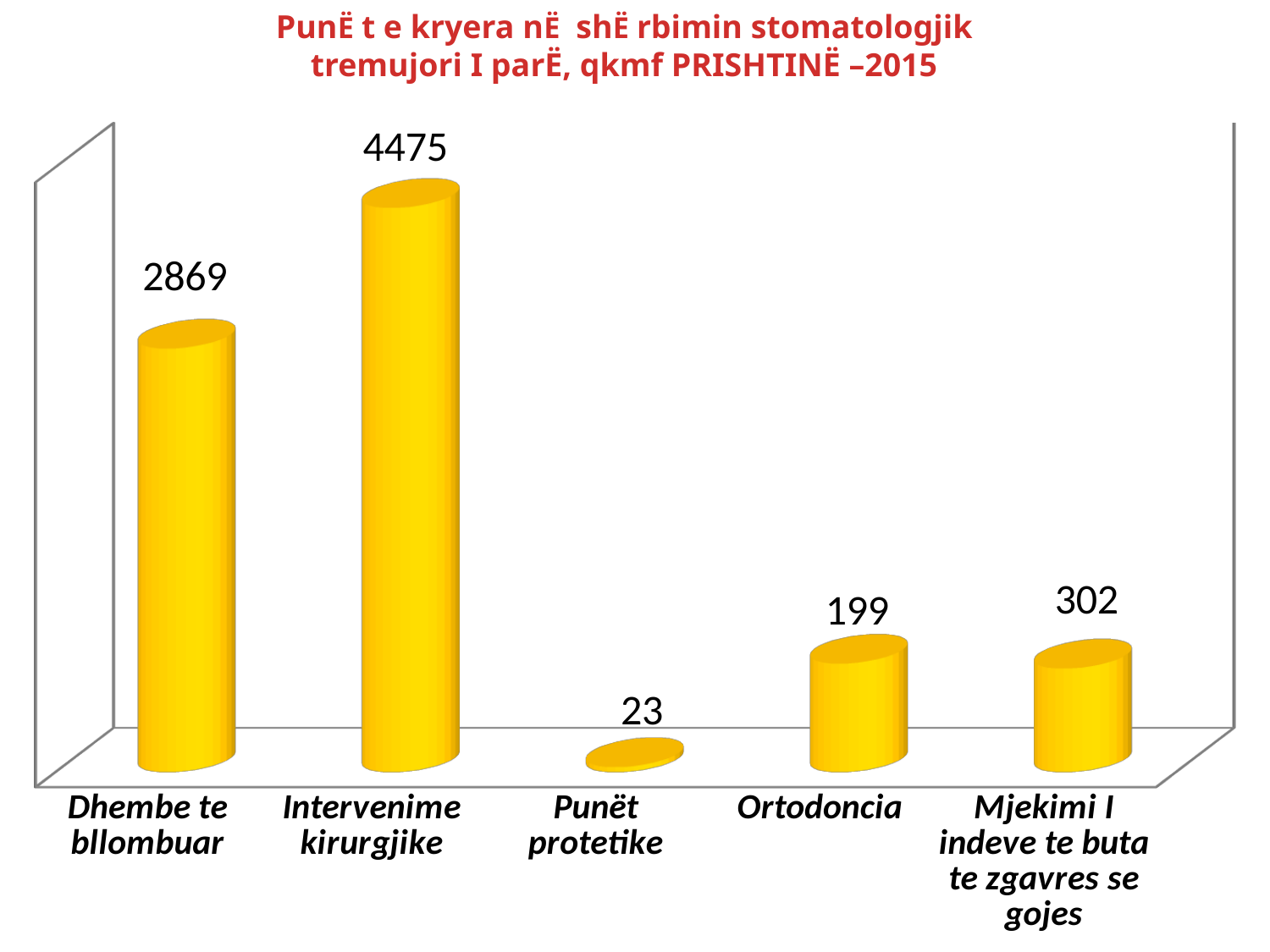
Which category has the highest value? Intervenime kirurgjike What is the difference between the values for Intervenime kirurgjike and Dhembe te bllombuar? 1606 What is the value for Ortodoncia? 199 What is the value for Intervenime kirurgjike? 4475 Which category has the lowest value? Punët protetike What is the value for Dhembe te bllombuar? 2869 What is the difference between the values for Mjekimi I indeve te buta te zgavres se gojes and Ortodoncia? 103 What kind of chart is shown on the slide? Bar chart What is the value for Punët protetike? 23 Which is larger, the value for Ortodoncia or the value for Mjekimi I indeve te buta te zgavres se gojes? Mjekimi I indeve te buta te zgavres se gojes How many categories are shown in the chart? 5 What is the value for Mjekimi I indeve te buta te zgavres se gojes? 302